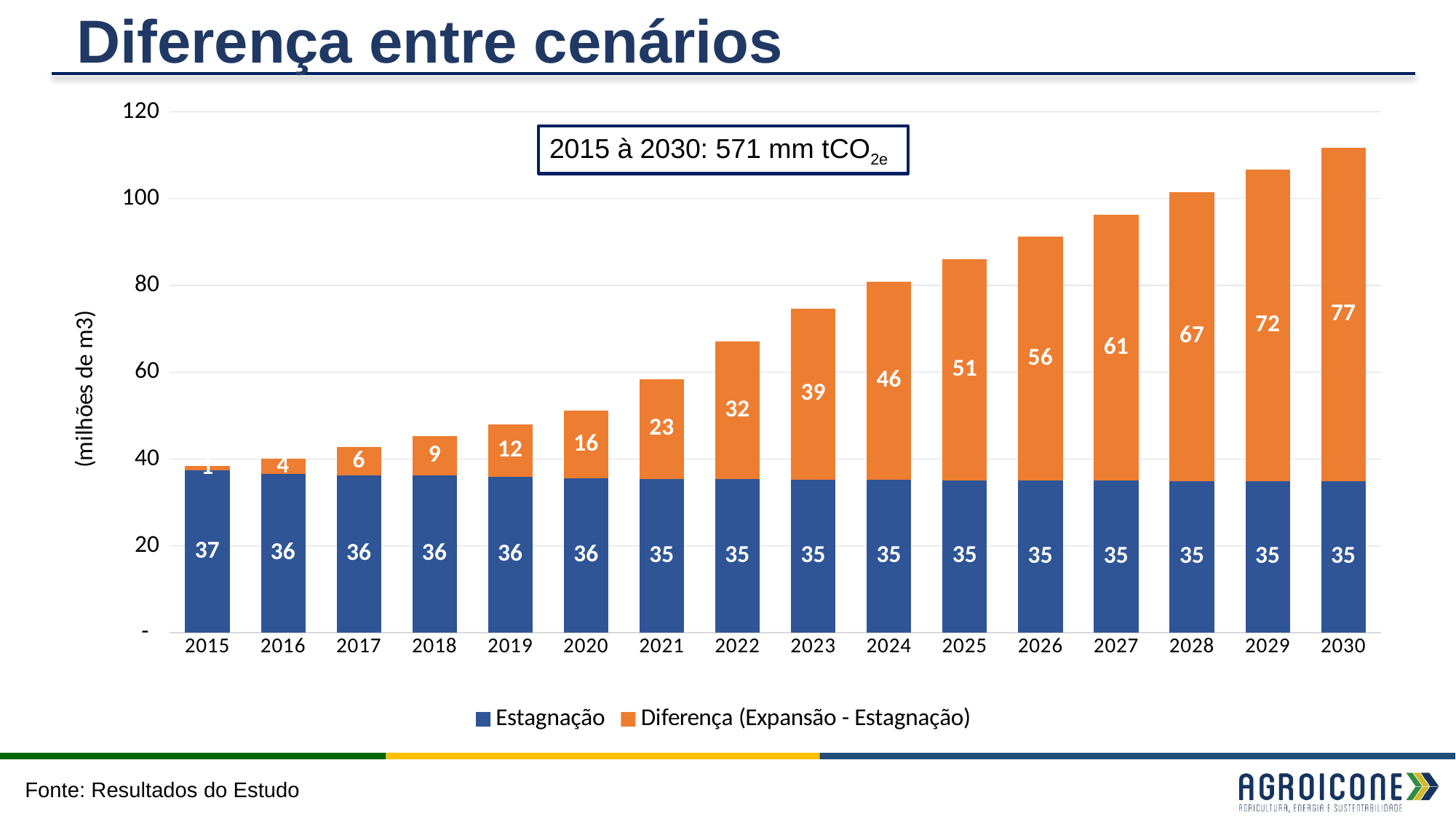
What is the difference between the Diferença (Expansão - Estagnação) values for 2030 and 2025? 26 What is the total of the stacked bar for 2030? 112 How many years are shown on the x axis? 16 How many series does the legend list? 2 In which year is the Diferença (Expansão - Estagnação) value highest? 2030 In which year is the Diferença (Expansão - Estagnação) value lowest? 2015 What is the value of Diferença (Expansão - Estagnação) for 2030? 77 What kind of chart is shown on the slide? stacked bar chart What is the value of Diferença (Expansão - Estagnação) for 2022? 32 Does the Diferença (Expansão - Estagnação) series rise or fall from 2015 to 2030? rise Which is larger, the Diferença (Expansão - Estagnação) value for 2024 or for 2021? 2024 What is the value of Estagnação for 2015? 37